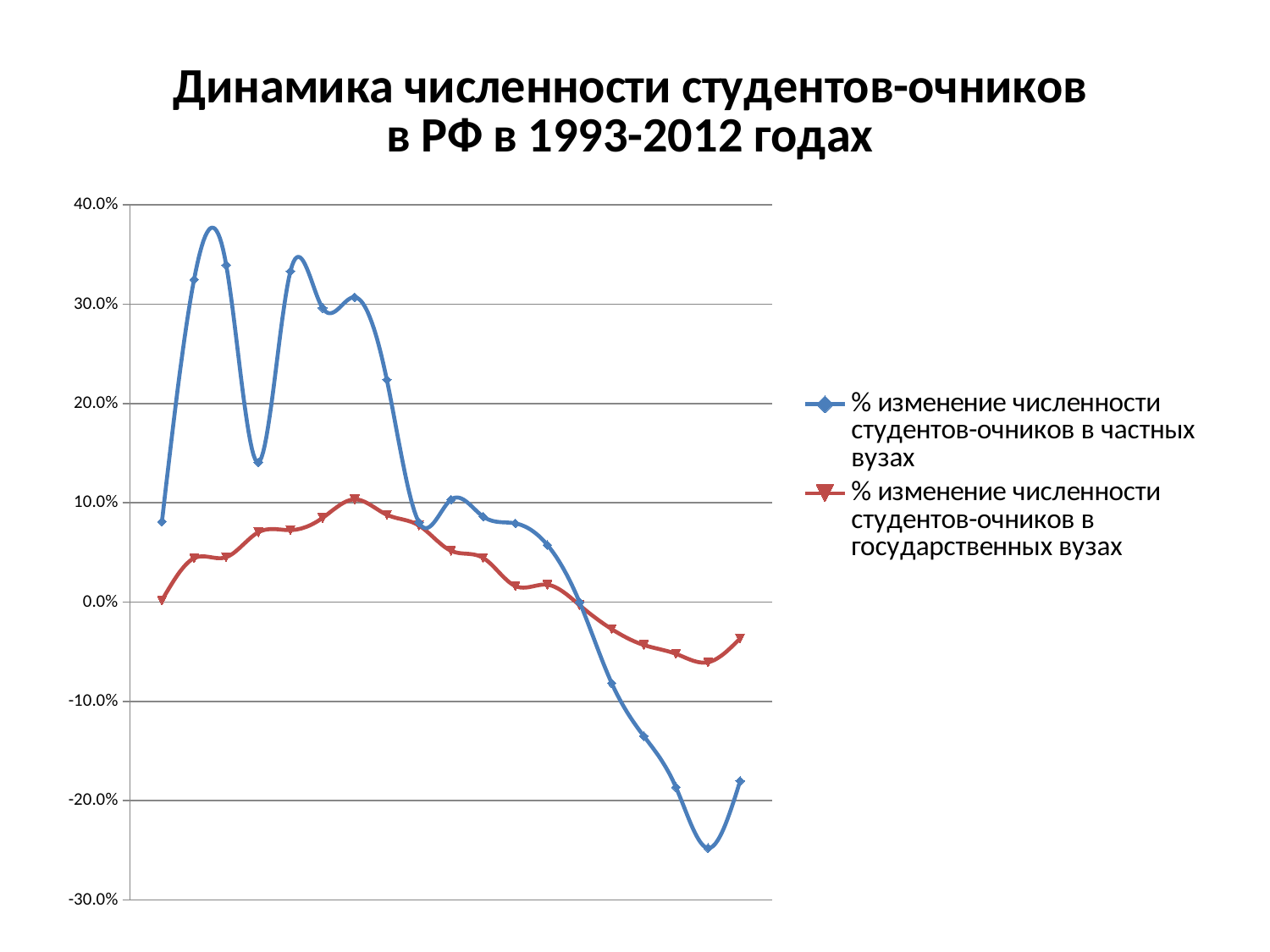
Is the last plotted value of the series for private universities (частных вузах) greater or less than -10.0%? less Is the lowest point of the series for private universities (частных вузах) greater or less than -20.0%? less Is the last plotted value of the series for state universities (государственных вузах) greater or less than -10.0%? greater What is the title of the chart? Динамика численности студентов-очников в РФ в 1993-2012 годах What kind of chart is shown on the slide? line chart Over the second half of the x axis, do the values of the series for private universities (частных вузах) generally rise or fall? fall Which colour is used for the series '% изменение численности студентов-очников в частных вузах'? blue Which series reaches the higher peak value: private universities (частных вузах) or state universities (государственных вузах)? частных вузах How many series does the legend list? 2 Which series has the lower value at the right end of the chart: private universities (частных вузах) or state universities (государственных вузах)? частных вузах